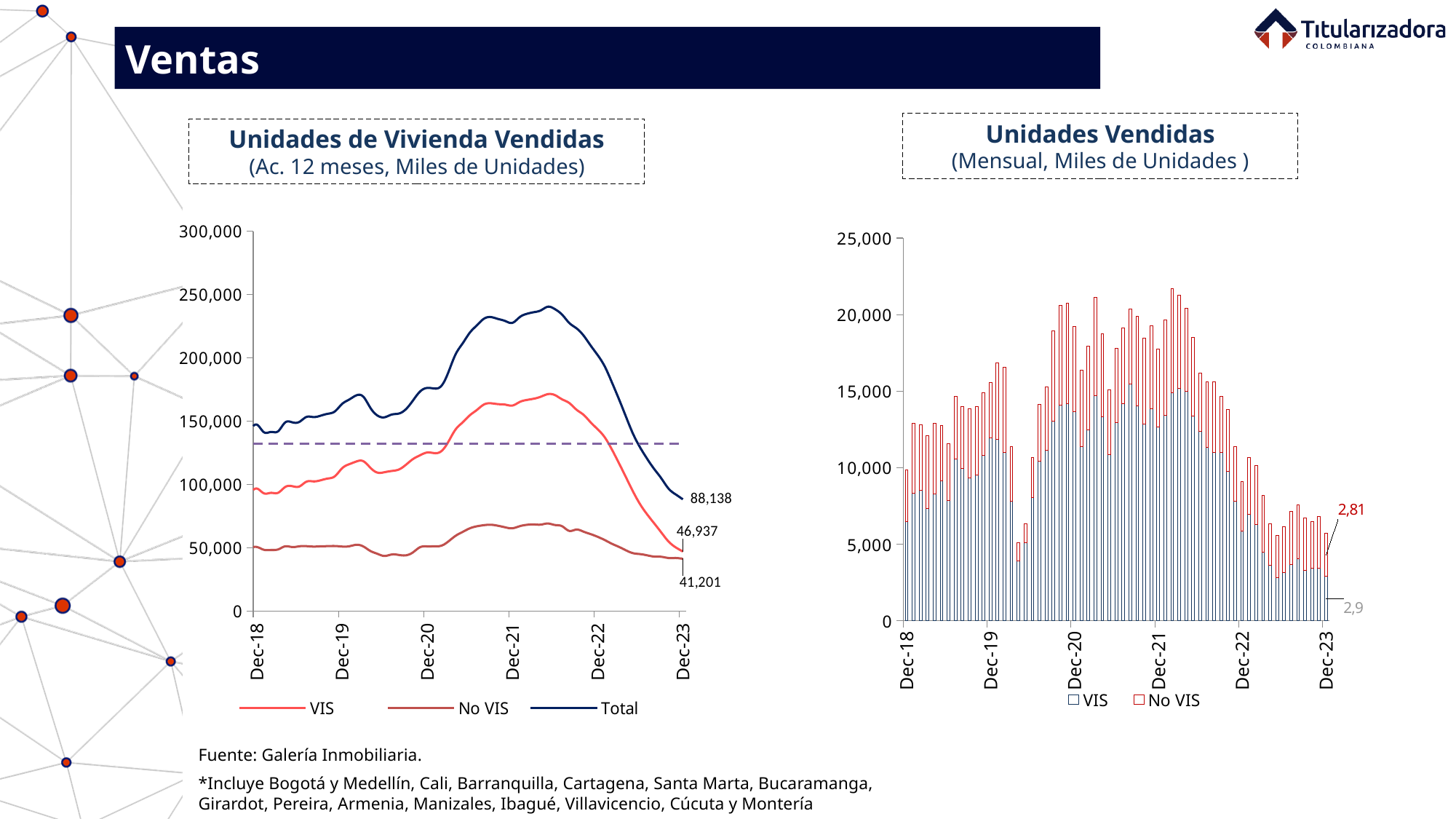
How many series does the legend of the right chart, 'Unidades Vendidas (Mensual)', list? 2 In the left chart, 'Unidades de Vivienda Vendidas', what is the value of the No VIS series at Dec-23? 41,201 In the left chart, 'Unidades de Vivienda Vendidas', does the Total series rise or fall between Dec-21 and Dec-23? fall In the left chart, 'Unidades de Vivienda Vendidas', what is the value of the VIS series at Dec-23? 46,937 What kind of chart is the right chart, 'Unidades Vendidas (Mensual)'? bar chart In the left chart, 'Unidades de Vivienda Vendidas', what is the value of the Total series at Dec-23? 88,138 In the left chart, 'Unidades de Vivienda Vendidas', is the Total value at Dec-21 greater or less than 200,000? greater In the right chart, 'Unidades Vendidas (Mensual)', is the total bar height at Dec-22 greater or less than 10,000? less What kind of chart is the left chart, 'Unidades de Vivienda Vendidas'? line chart How many series does the legend of the left chart, 'Unidades de Vivienda Vendidas', list? 3 In the left chart, 'Unidades de Vivienda Vendidas', what is the difference between the VIS and No VIS values at Dec-23? 5,736 In the left chart, 'Unidades de Vivienda Vendidas', which is larger at Dec-23: VIS or No VIS? VIS